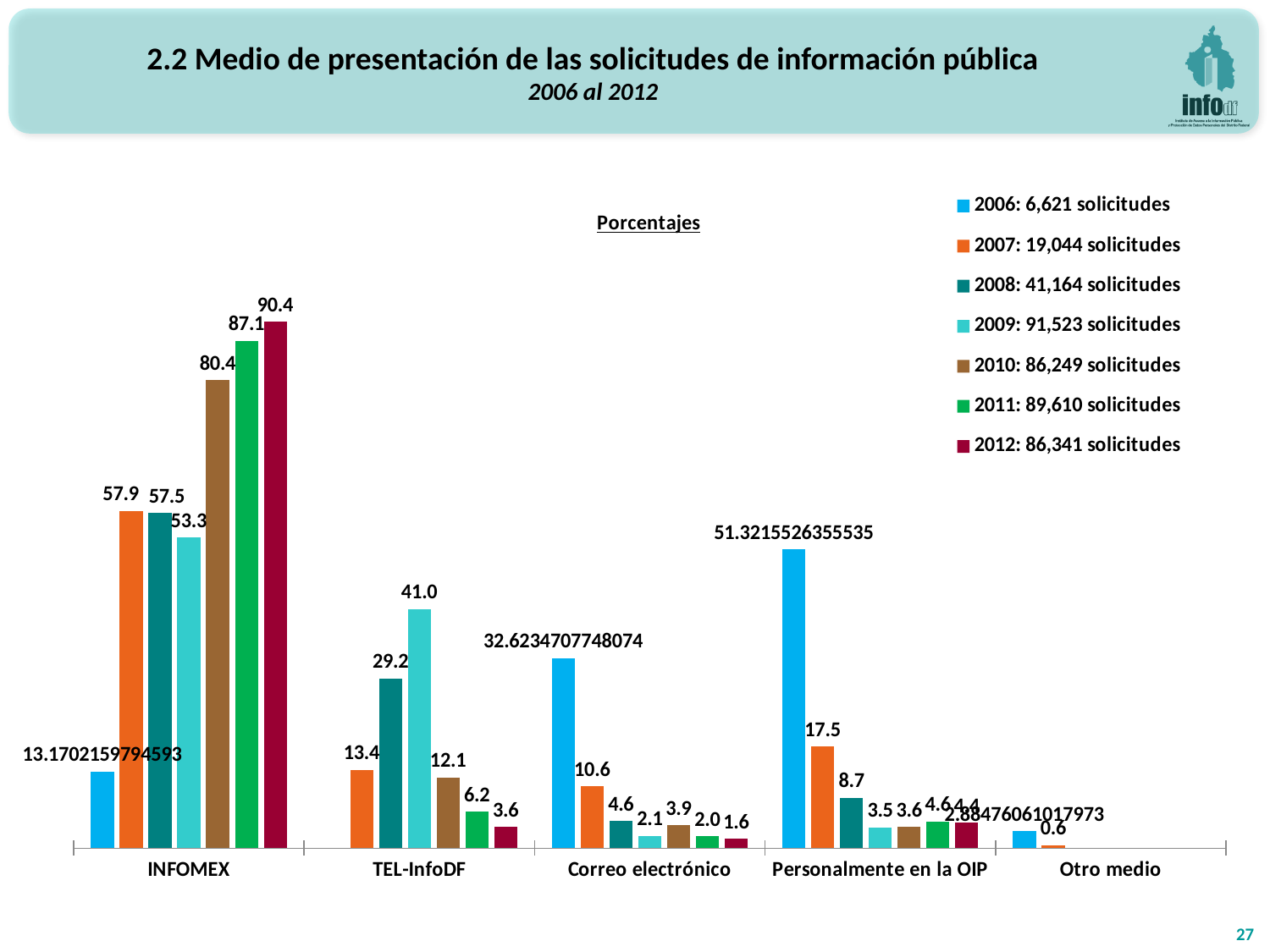
For TEL-InfoDF, which year has the larger percentage, 2007 or 2008? 2008 What is the difference between the INFOMEX percentages for 2012 and 2011? 3.3 What is the percentage for INFOMEX in 2012? 90.4 How many categories (medios) are shown on the x axis? 5 What kind of chart is shown on the slide? Bar chart What is the percentage for TEL-InfoDF in 2009? 41.0 For INFOMEX, do the percentages rise or fall from 2010 to 2012? Rise How many series does the legend list? 7 Which year has the lowest percentage for Correo electrónico? 2012 According to the legend, how many solicitudes were there in 2009? 91,523 What is the percentage for Personalmente en la OIP in 2007? 17.5 Which year has the highest percentage for INFOMEX? 2012